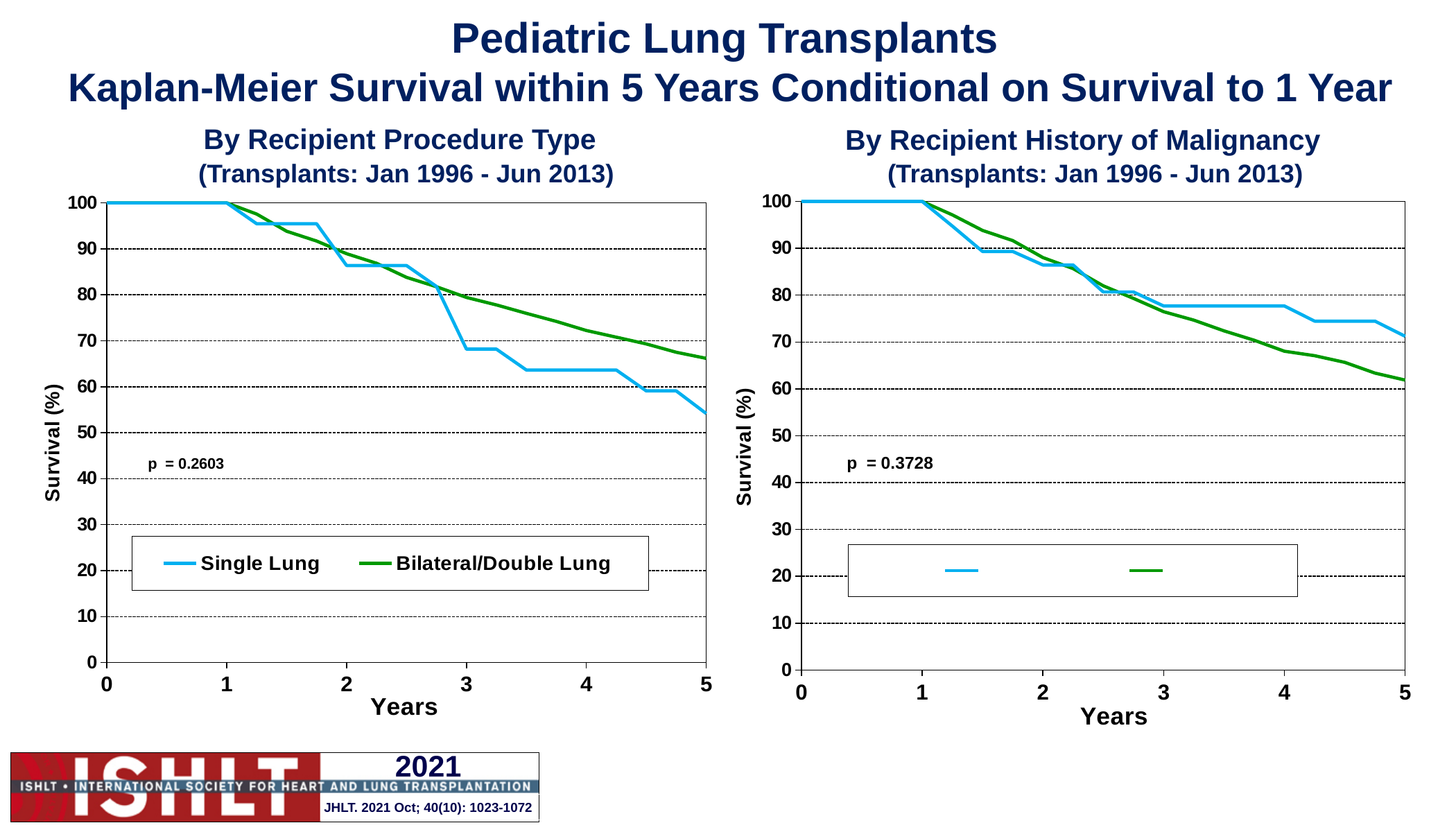
In the left chart, 'By Recipient Procedure Type', which two series are named in the legend? Single Lung and Bilateral/Double Lung In the left chart, 'By Recipient Procedure Type', which series has the higher survival at 5 years, Single Lung or Bilateral/Double Lung? Bilateral/Double Lung In the right chart, 'By Recipient History of Malignancy', which line has the higher survival at 5 years, the blue line or the green line? The blue line What p-value is printed on the left chart, 'By Recipient Procedure Type'? p = 0.2603 In the left chart, 'By Recipient Procedure Type', is the Single Lung survival at 5 years greater or less than 60? less In the right chart, 'By Recipient History of Malignancy', is the green line's survival at 5 years greater or less than 70? less How many series does the legend of the left chart, 'By Recipient Procedure Type', list? 2 What kind of chart is the left chart, 'By Recipient Procedure Type'? Line chart In the right chart, 'By Recipient History of Malignancy', is the blue line's survival at 4 years greater or less than 80? less In the left chart, 'By Recipient Procedure Type', does the Single Lung survival rise or fall as years increase? Fall In the right chart, 'By Recipient History of Malignancy', does the green line's survival rise or fall as years increase? Fall